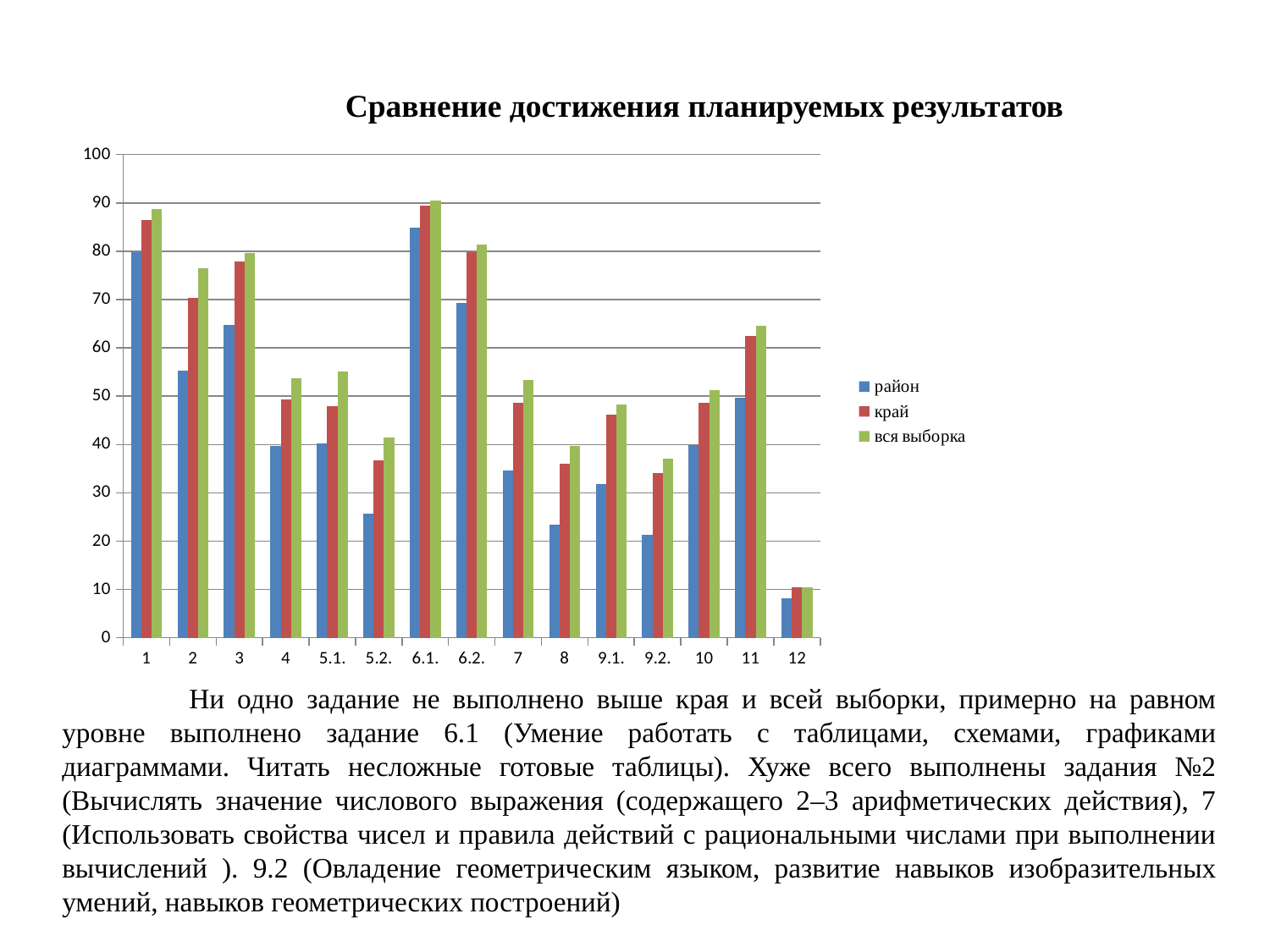
Which category has the lowest value for the series 'район'? 12 Which category has the highest value for the series 'район'? 6.1. Which is larger for the series 'край': category 11 or category 10? 11 What is the title of the chart? Сравнение достижения планируемых результатов What kind of chart is shown on the slide? bar chart Is the value for 'район' in category 2 greater or less than 50? greater Is the value for 'вся выборка' in category 2 greater or less than 70? greater Is the value for 'район' in category 7 greater or less than 40? less Which category has the lowest value for the series 'вся выборка'? 12 How many series does the legend list? 3 How many categories are shown on the x axis? 15